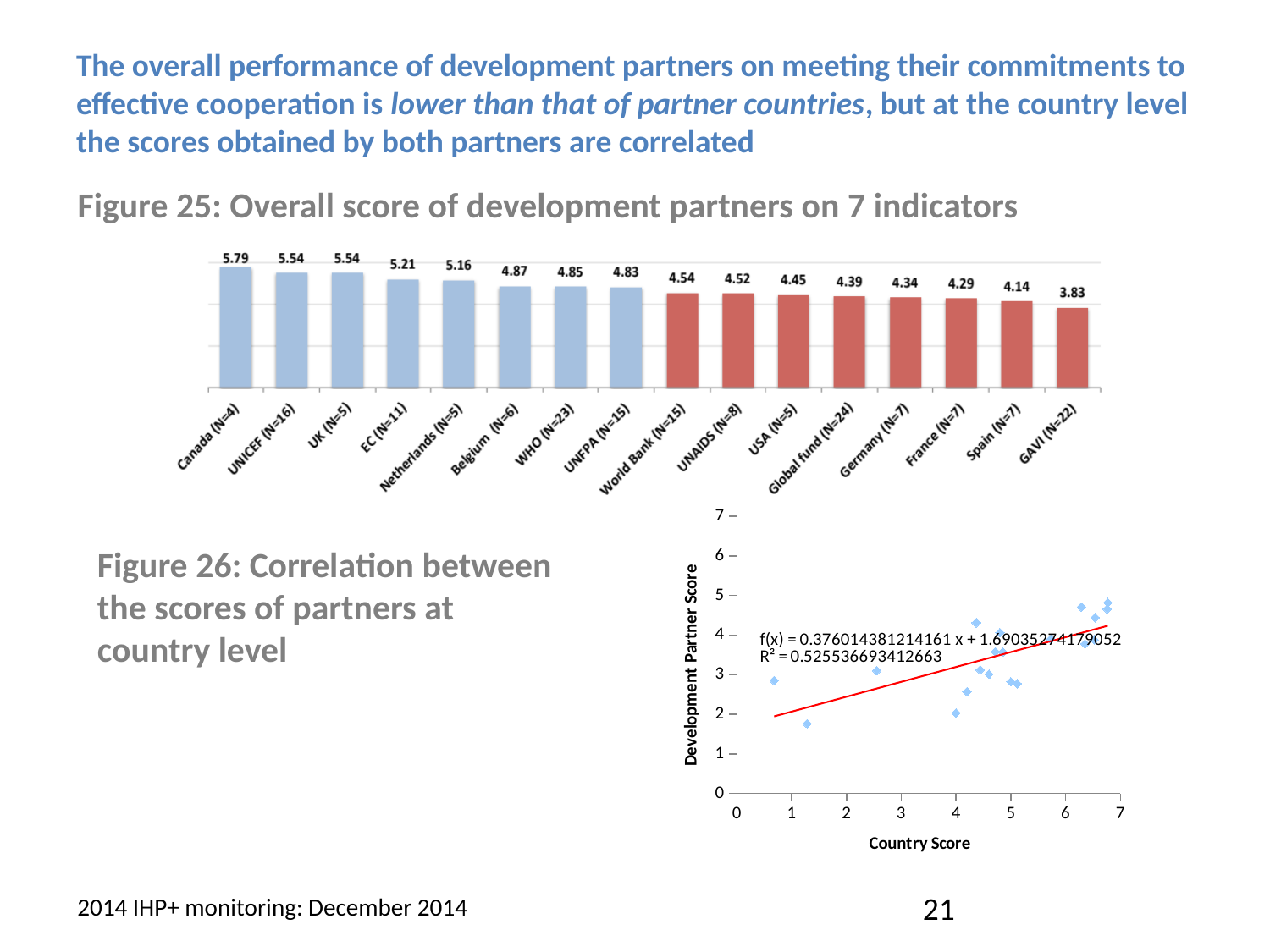
In Figure 26, does the trend line rise or fall as Country Score increases? Rises In Figure 26, what is the label of the horizontal axis? Country Score In Figure 25, which development partner has the lowest overall score? GAVI (N=22) In Figure 25, which development partner has the highest overall score? Canada (N=4) In Figure 25, which has a higher overall score, EC (N=11) or USA (N=5)? EC (N=11) In Figure 25, what is the overall score for WHO (N=23)? 4.85 In Figure 25, how many development partners are shown as bars? 16 What kind of chart is Figure 26? Scatter plot What kind of chart is Figure 25? Bar chart In Figure 25, what is the difference between the scores of Canada (N=4) and GAVI (N=22)? 1.96 In Figure 25, what is the overall score for GAVI (N=22)? 3.83 In Figure 25, what is the overall score for Canada (N=4)? 5.79